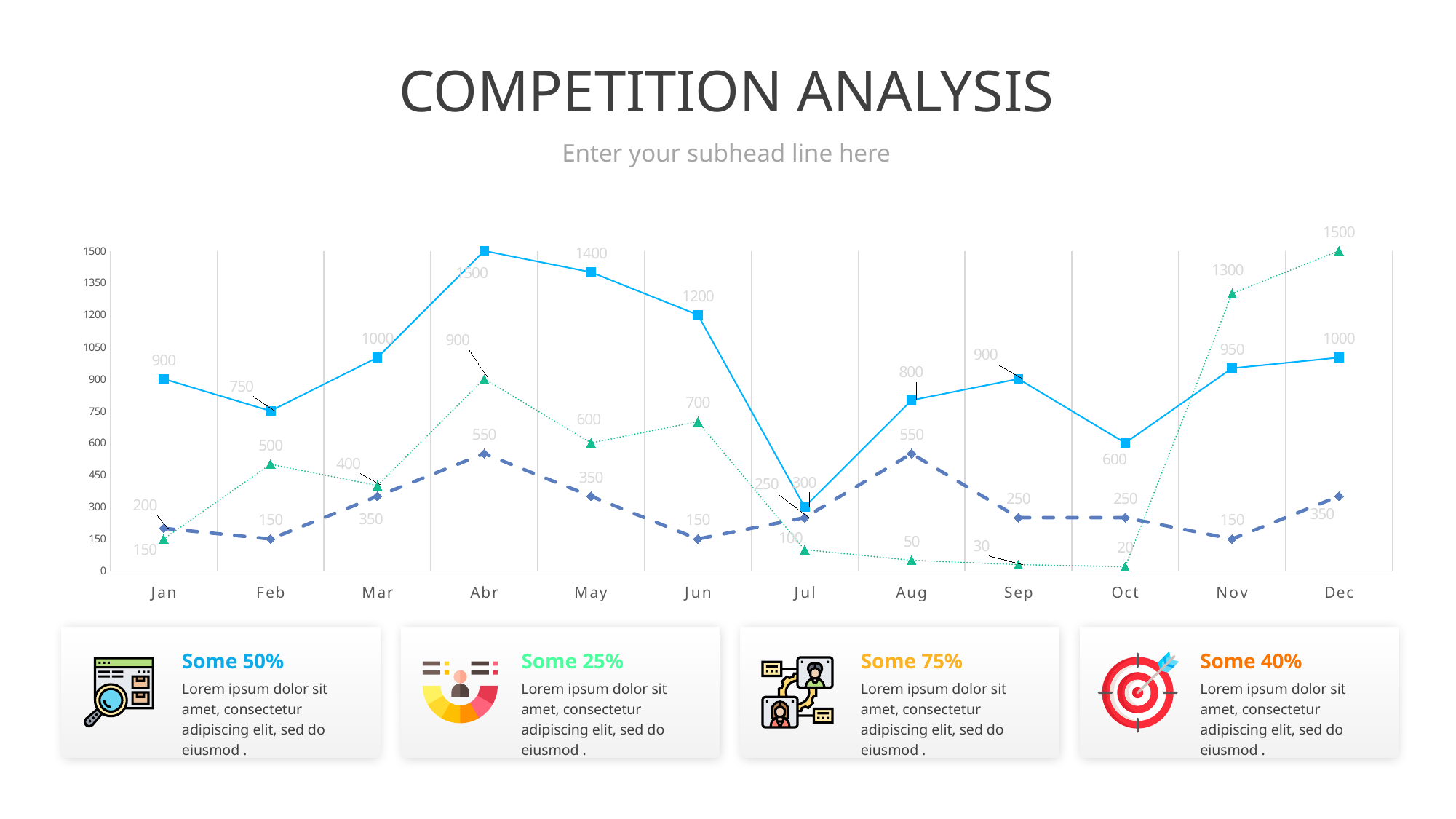
Does the solid blue line with square markers rise or fall from Abr to Jul? fall In which month does the green dotted line with triangle markers reach its lowest value? Oct In Nov, which line has the higher value: the green dotted line or the solid blue line? the green dotted line How many lines are plotted on the chart? 3 What is the value of the solid blue line with square markers in Abr? 1500 What is the value of the dashed line with diamond markers in Aug? 550 What is the difference between the solid blue line's values in Jun and Jul? 900 What kind of chart is shown on the slide? line chart What is the value of the green dotted line with triangle markers in Sep? 30 What is the value of the green dotted line with triangle markers in Dec? 1500 How many months are shown on the x axis of the chart? 12 In which month does the solid blue line with square markers reach its highest value? Abr